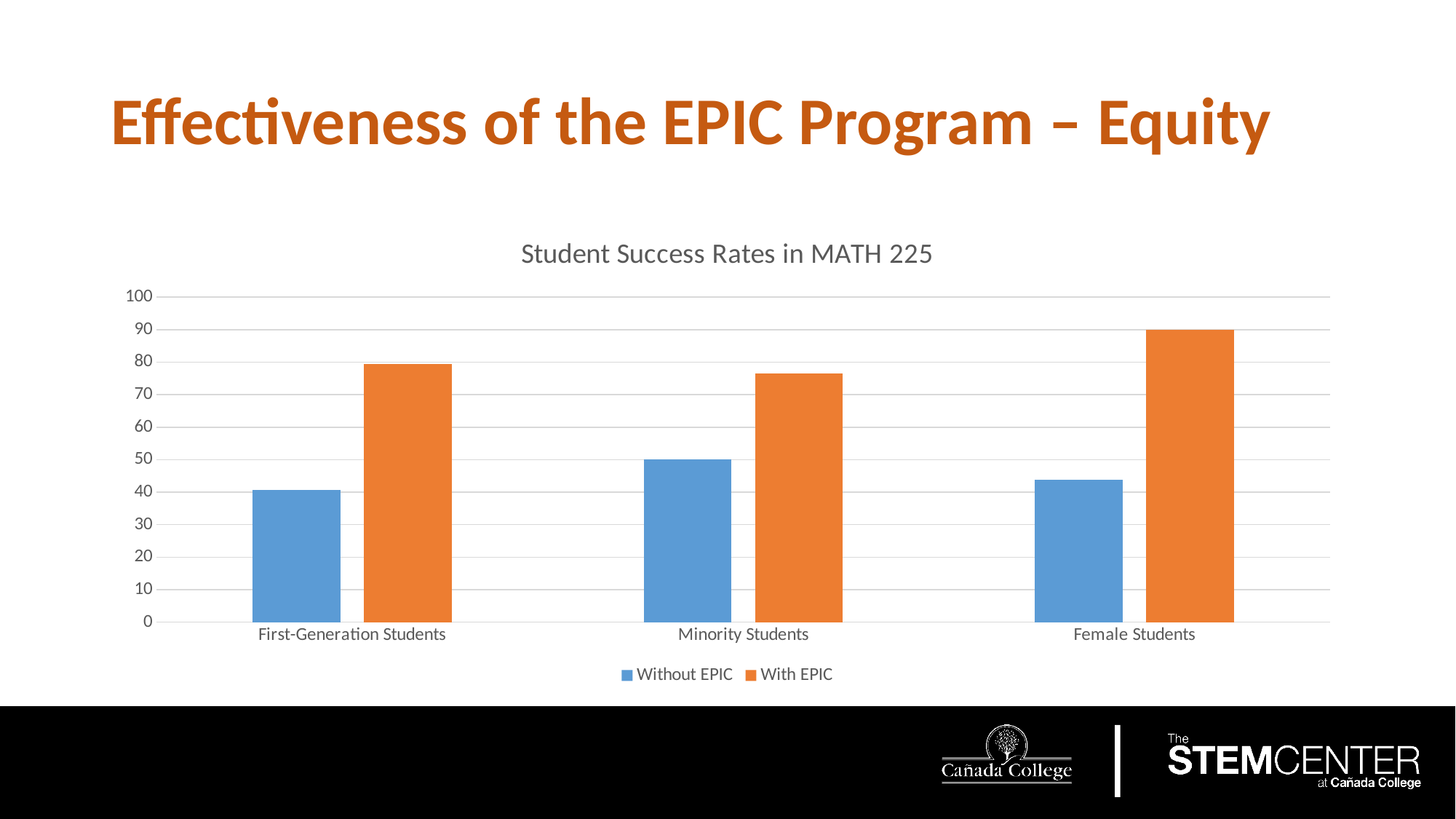
What is the title of the chart? Student Success Rates in MATH 225 How many series does the legend list? 2 Which student group has the lowest success rate Without EPIC? First-Generation Students Is the Without EPIC value for First-Generation Students greater or less than 50? less Which student group has the lowest success rate With EPIC? Minority Students How many student groups are shown on the x axis? 3 Is the With EPIC value for Minority Students greater or less than 80? less For Female Students, which is larger: the Without EPIC value or the With EPIC value? With EPIC Which student group has the highest success rate With EPIC? Female Students What kind of chart is shown on the slide? bar chart Is the With EPIC value for First-Generation Students greater or less than 70? greater Which student group has the highest success rate Without EPIC? Minority Students